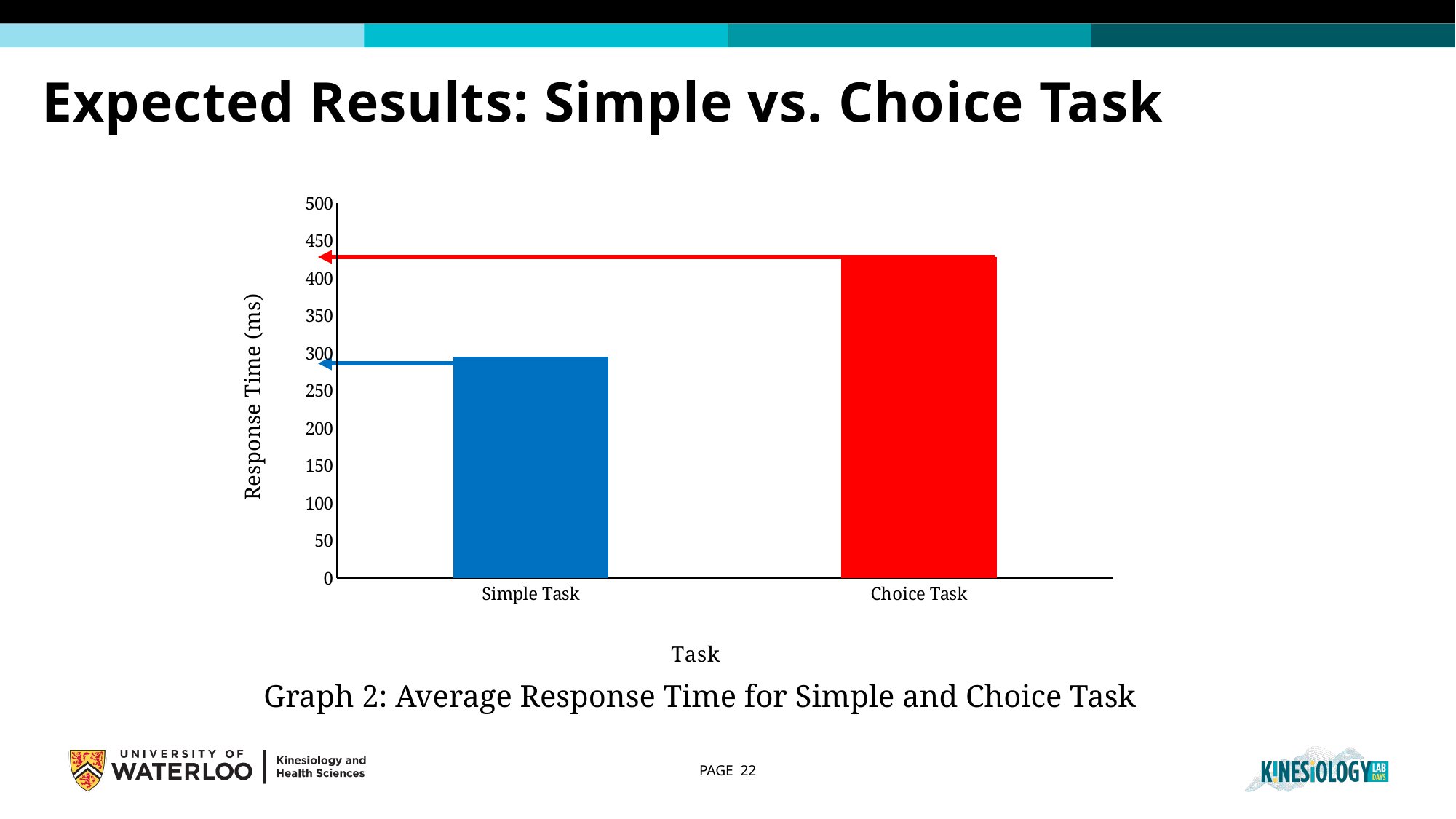
Which task has the lowest response time? Simple Task Is the value for Choice Task greater or less than 400? greater What colour is the bar for Choice Task? red Is the value for Simple Task greater or less than 350? less Is the value for Simple Task greater or less than 250? greater What is the label of the y axis? Response Time (ms) What kind of chart is shown on the slide? bar chart Which has a larger response time, Simple Task or Choice Task? Choice Task How many task categories are plotted on the x axis? 2 Which task has the highest response time? Choice Task